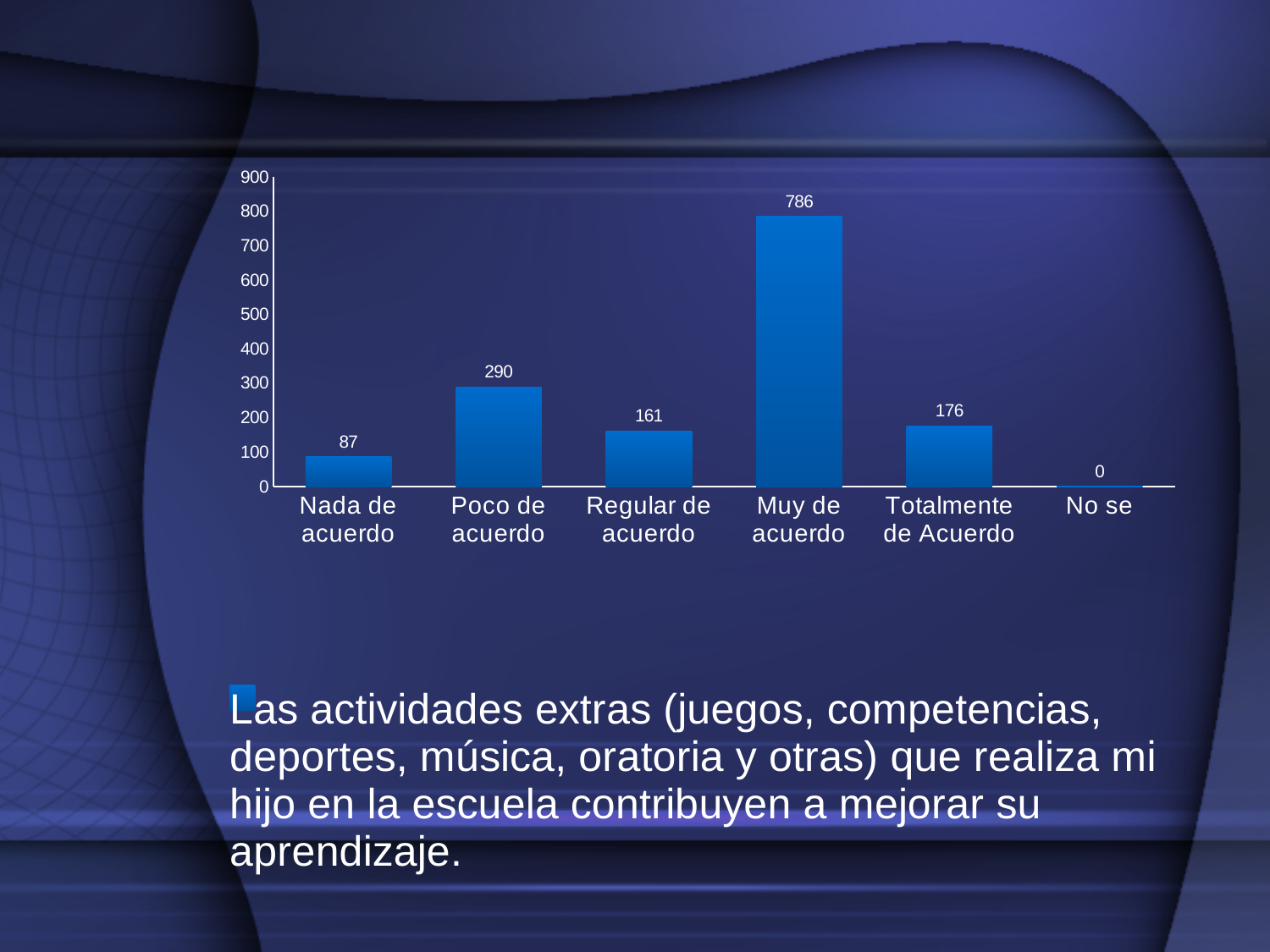
How many categories are shown on the x axis? 6 What is the value for "Poco de acuerdo"? 290 What is the difference between the values for "Totalmente de Acuerdo" and "Regular de acuerdo"? 15 What is the difference between the values for "Muy de acuerdo" and "Poco de acuerdo"? 496 Is the value for "Muy de acuerdo" greater or less than 700? greater What is the value for "Muy de acuerdo"? 786 What is the value for "Nada de acuerdo"? 87 What is the value for "No se"? 0 Which is larger, the value for "Poco de acuerdo" or the value for "Totalmente de Acuerdo"? Poco de acuerdo Which category has the highest value? Muy de acuerdo What kind of chart is shown on the slide? bar chart Which category has the lowest value? No se